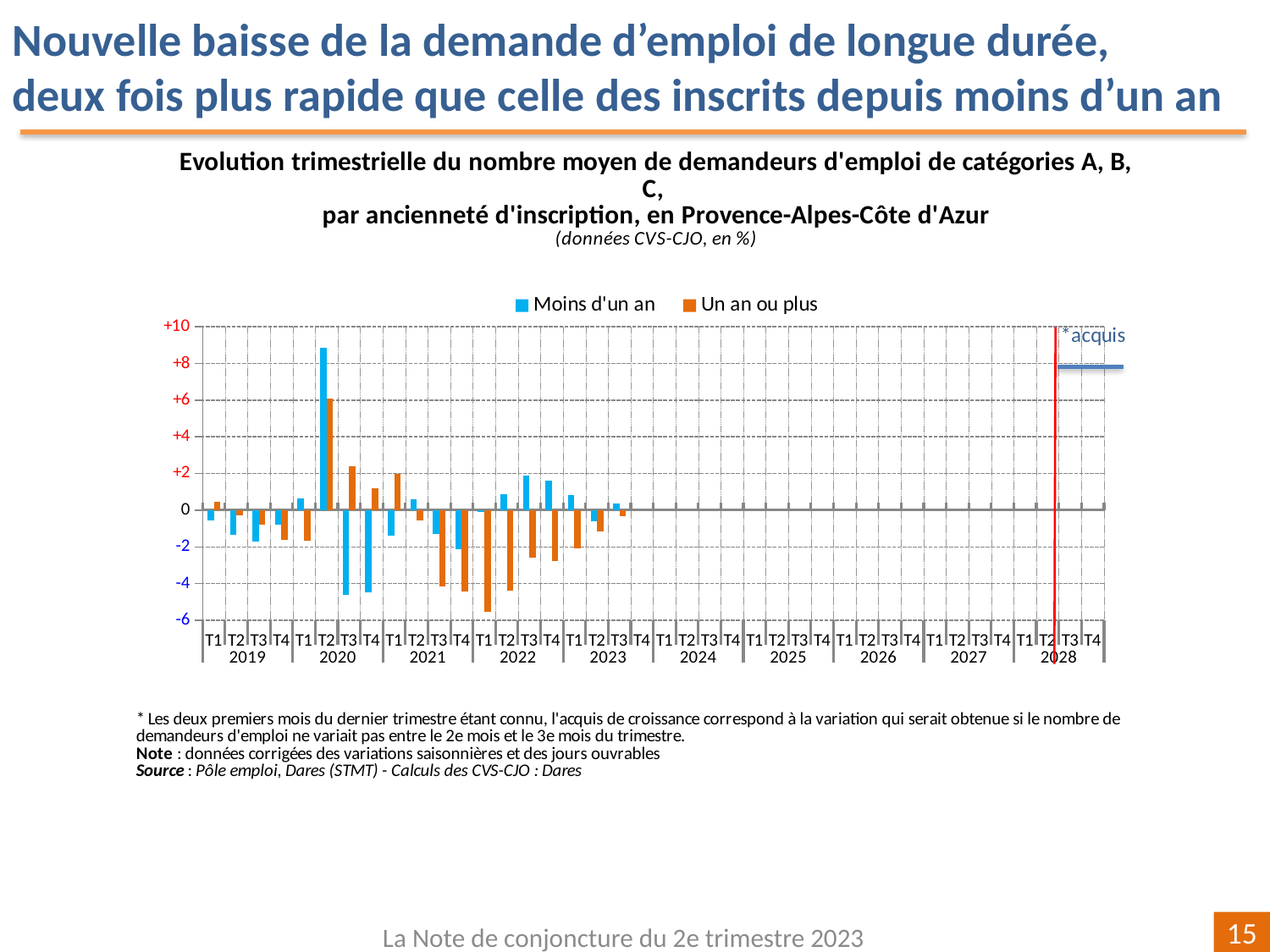
In T2 2020, which series has the larger value, 'Moins d'un an' or 'Un an ou plus'? Moins d'un an Is the value for 'Un an ou plus' in T2 2020 greater or less than +4? greater Which two series are listed in the legend? Moins d'un an; Un an ou plus In which quarter does the 'Un an ou plus' series reach its highest value? T2 2020 How many series does the legend list? 2 In which quarter does the 'Moins d'un an' series reach its highest value? T2 2020 Does the 'Un an ou plus' series rise or fall from T1 2021 to T1 2022? fall Is the value for 'Moins d'un an' in T2 2020 greater or less than +8? greater In which quarter does the 'Un an ou plus' series reach its lowest value? T1 2022 How many years are labelled along the x axis? 10 Is the value for 'Un an ou plus' in T1 2022 greater or less than -4? less What kind of chart is shown on the slide? bar chart